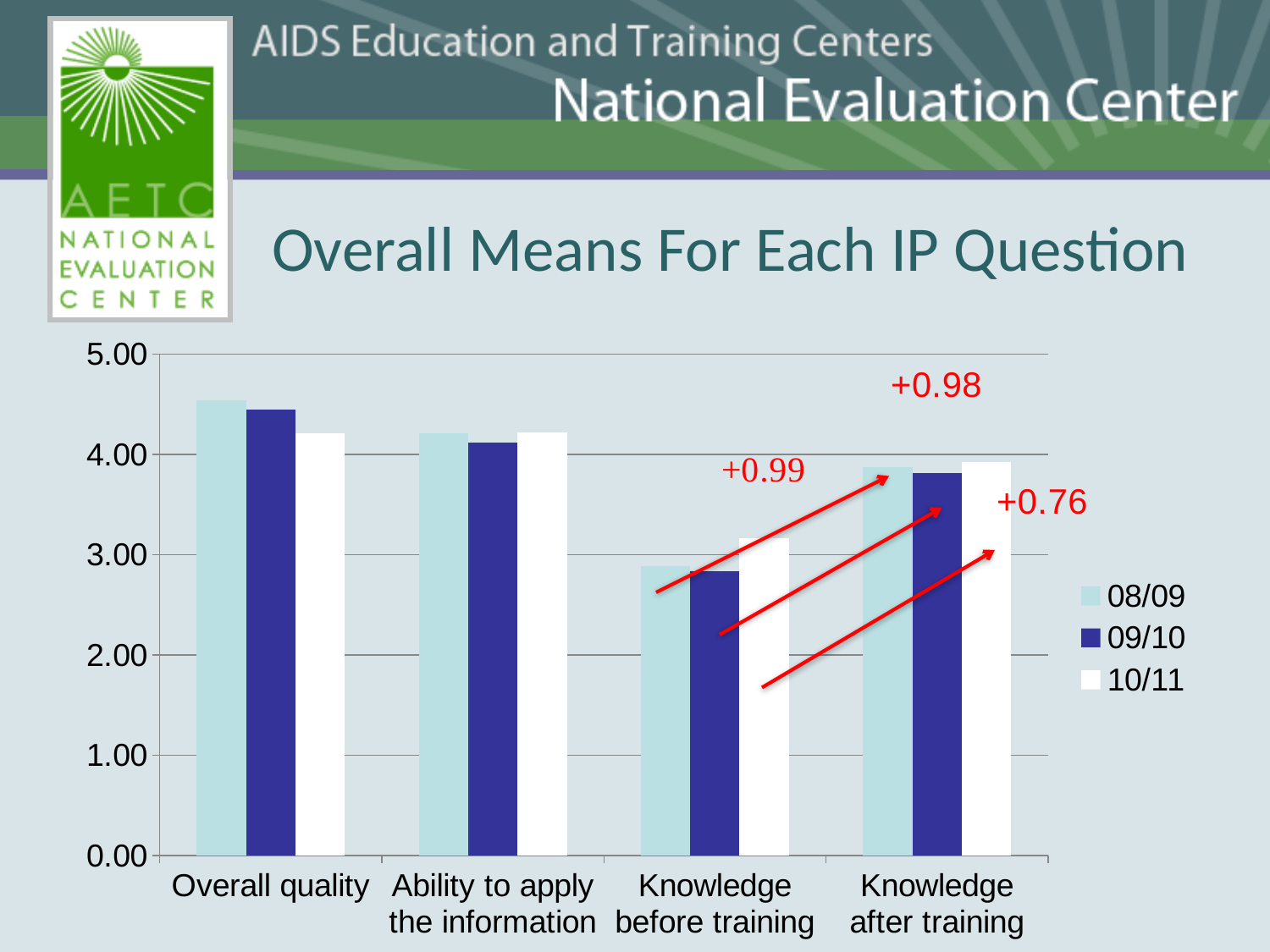
How many series does the legend list? 3 What are the series names listed in the legend? 08/09, 09/10, 10/11 Which category has the highest value for the 09/10 series? Overall quality For the 10/11 series, which is larger: Overall quality or Knowledge before training? Overall quality Which category has the lowest value for the 08/09 series? Knowledge before training What type of chart is shown on the slide? bar chart How many categories are shown on the x axis of the chart? 4 Is the 08/09 value for Overall quality greater or less than 4.00? greater Is the 10/11 value for Knowledge after training greater or less than 4.00? less Is the 09/10 value for Knowledge before training greater or less than 3.00? less What is the title of the chart? Overall Means For Each IP Question